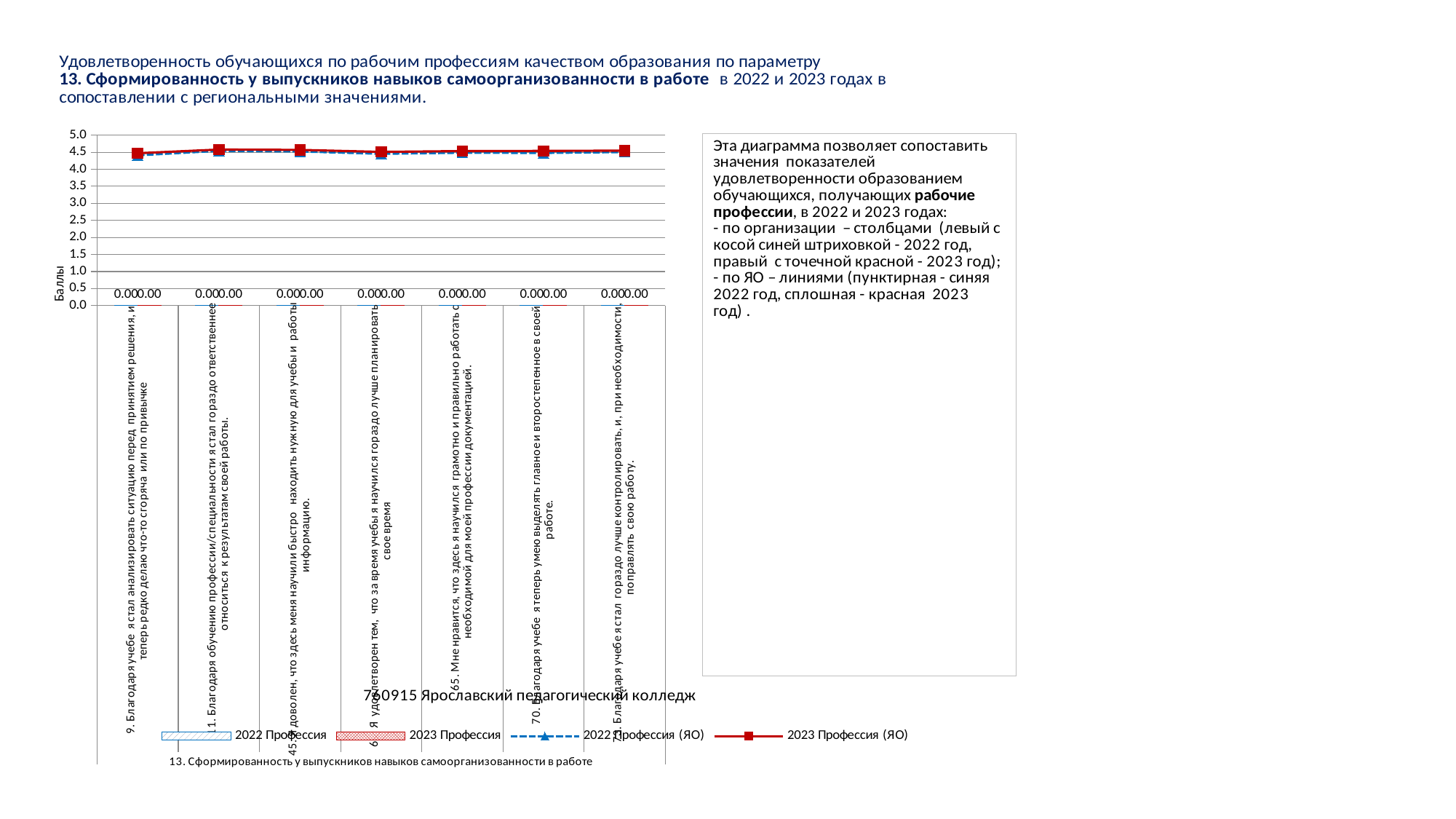
How many series does the chart legend list? 4 What is the maximum value shown on the vertical axis of the chart? 5.0 Which series in the legend is drawn as a solid red line with square markers? 2023 Профессия (ЯО) What kind of chart is shown on the slide? Combined bar and line chart What value is printed as the data label for the 2022 Профессия bar in the first category? 0.00 What is the title of the vertical axis of the chart? Баллы Is the value of the 2022 Профессия (ЯО) line for category "45. Я доволен, что здесь меня научили быстро находить нужную для учебы и работы информацию." greater or less than 4.0? greater Is the value of the 2023 Профессия (ЯО) line for category "65. Мне нравится, что здесь я научился грамотно и правильно работать с необходимой для моей профессии документацией." greater or less than 5.0? less Is the value of the 2022 Профессия (ЯО) line for category "70. Благодаря учебе я теперь умею выделять главное и второстепенное в своей работе." greater or less than 3.5? greater How many categories are shown along the x axis of the chart? 7